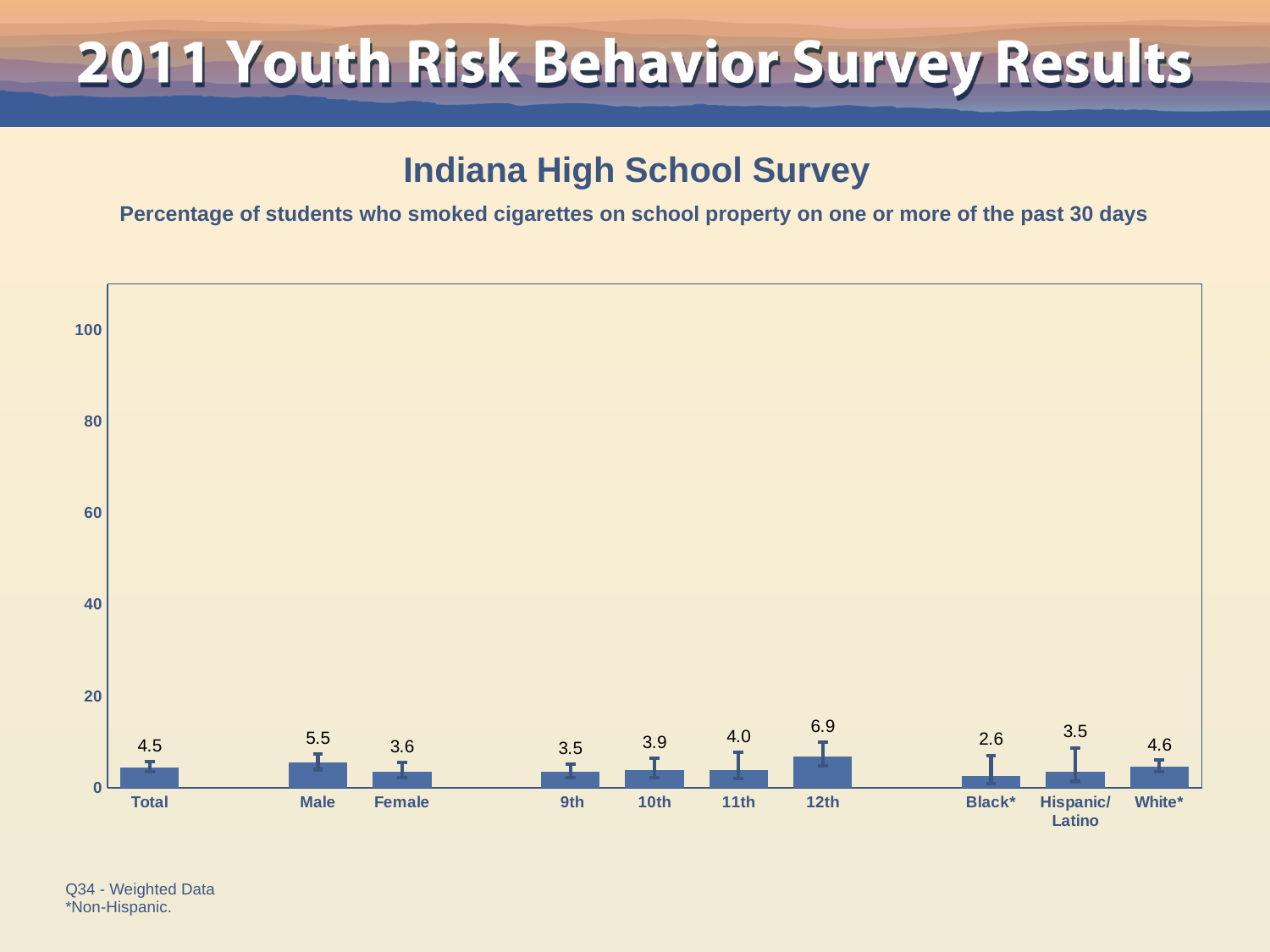
What is the title of the chart? Indiana High School Survey Which is larger, the value for 9th grade or the value for 11th grade? 11th What kind of chart is this? bar chart Which category has the lowest value? Black* What is the value for Total? 4.5 Which category has the highest value? 12th What is the value for Hispanic/Latino students? 3.5 What is the value for 12th grade? 6.9 How many categories are shown on the x axis? 10 What is the difference between the Male and Female values? 1.9 Do the values rise or fall from 9th grade to 12th grade? rise Is the value for 12th grade greater or less than 20? less